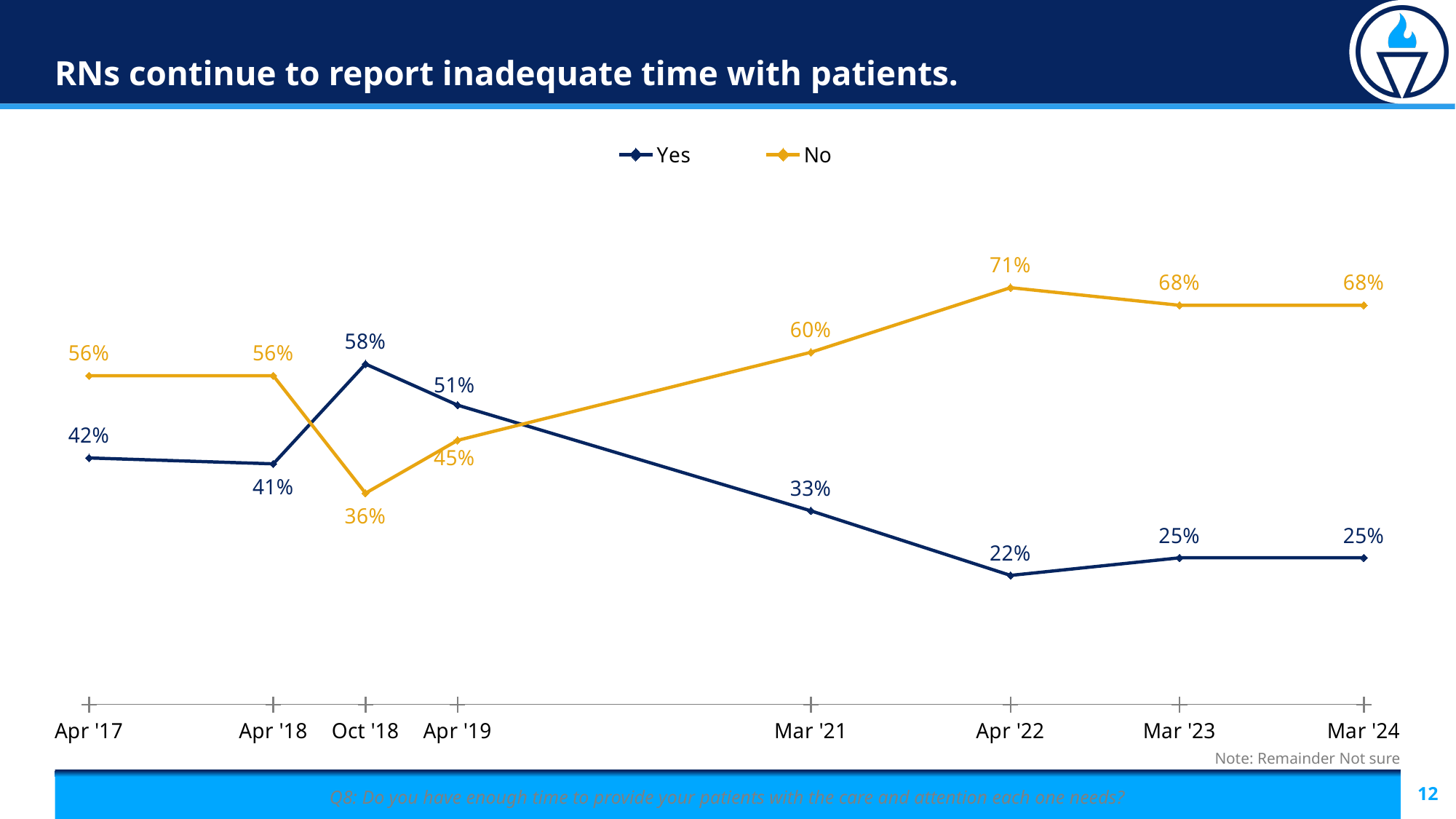
What is the value for Yes in Mar '24? 25% Does the Yes series rise or fall from Oct '18 to Apr '22? Fall What kind of chart is shown on the slide? Line chart What is the value for No in Apr '22? 71% How many dates are plotted on the x axis? 8 How many series does the legend list? 2 At which date is the Yes series lowest? Apr '22 At which date is the Yes series highest? Oct '18 What is the value for Yes in Apr '17? 42% What is the difference between the No and Yes values in Mar '24? 43% Which is larger in Apr '19, Yes or No? Yes What is the value for No in Oct '18? 36%